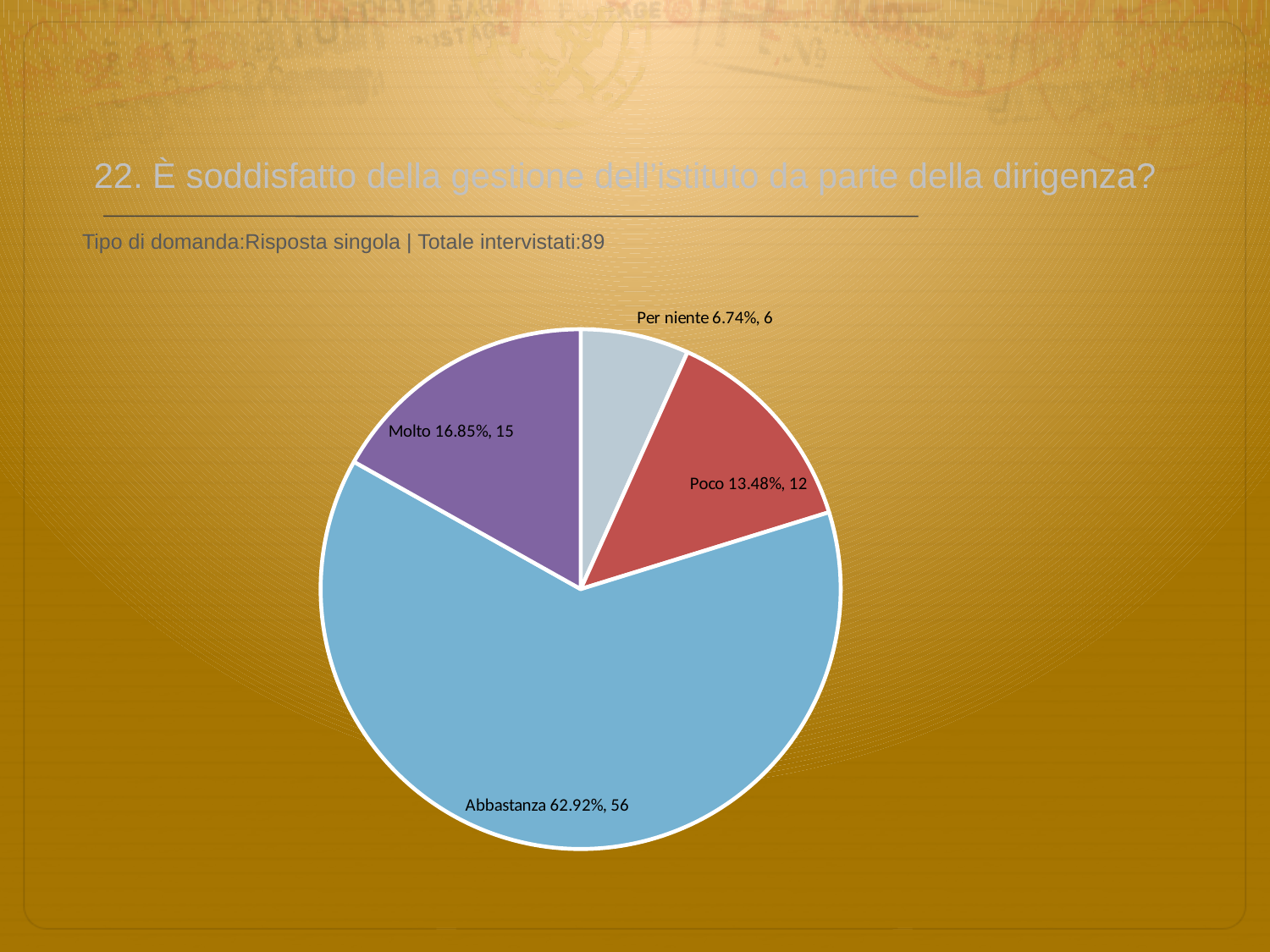
What share of the pie does the 'Abbastanza' slice represent? 62.92% How many respondents answered 'Poco'? 12 Which has more respondents, 'Molto' or 'Poco'? Molto What percentage is shown for 'Per niente'? 6.74% What kind of chart is shown on the slide? pie chart What is the difference in respondent count between 'Abbastanza' and 'Molto'? 41 How many slices does the pie chart have? 4 How many respondents answered 'Molto'? 15 What colour is the 'Poco' slice? red Which category has the largest slice of the pie? Abbastanza What is the total number of respondents across all slices? 89 Which category has the smallest slice of the pie? Per niente